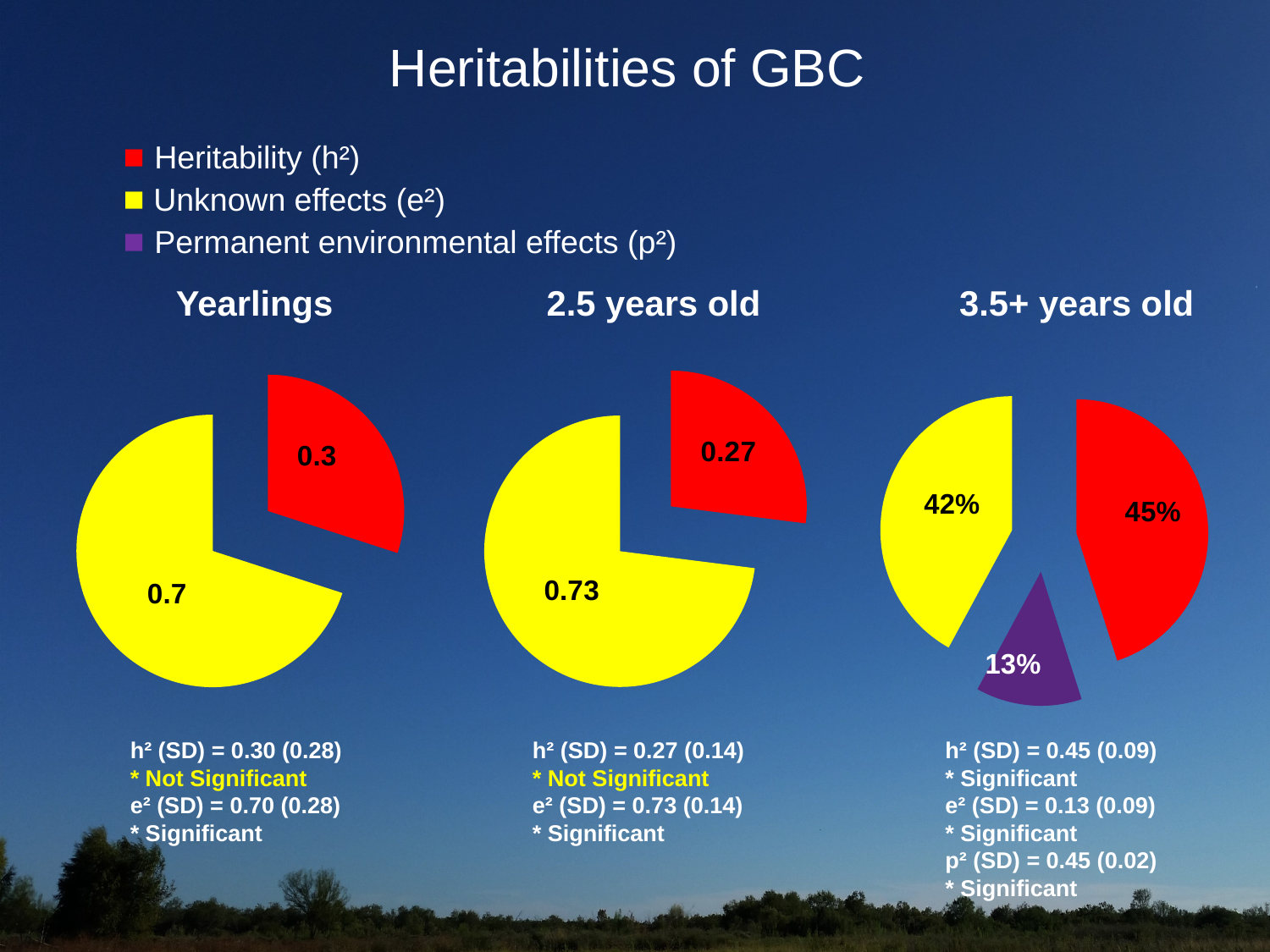
How many slices does the 3.5+ years old pie chart have? 3 In the Yearlings pie chart, what value is shown for the Unknown effects (e²) slice? 0.7 In the 3.5+ years old pie chart, which slice is the largest? Heritability (h²) Which is larger: the Heritability (h²) value in the Yearlings chart or in the 2.5 years old chart? Yearlings In the 2.5 years old pie chart, what value is shown for the Heritability (h²) slice? 0.27 In the 3.5+ years old pie chart, what share is shown for the Heritability (h²) slice? 45% What type of chart is used for the Yearlings data? Pie chart In the 3.5+ years old pie chart, what share is shown for the Permanent environmental effects (p²) slice? 13% In the Yearlings pie chart, what is the difference between the Unknown effects (e²) value and the Heritability (h²) value? 0.4 In the 2.5 years old pie chart, what value is shown for the Unknown effects (e²) slice? 0.73 In the 3.5+ years old pie chart, which slice is the smallest? Permanent environmental effects (p²) In the Yearlings pie chart, what value is shown for the Heritability (h²) slice? 0.3